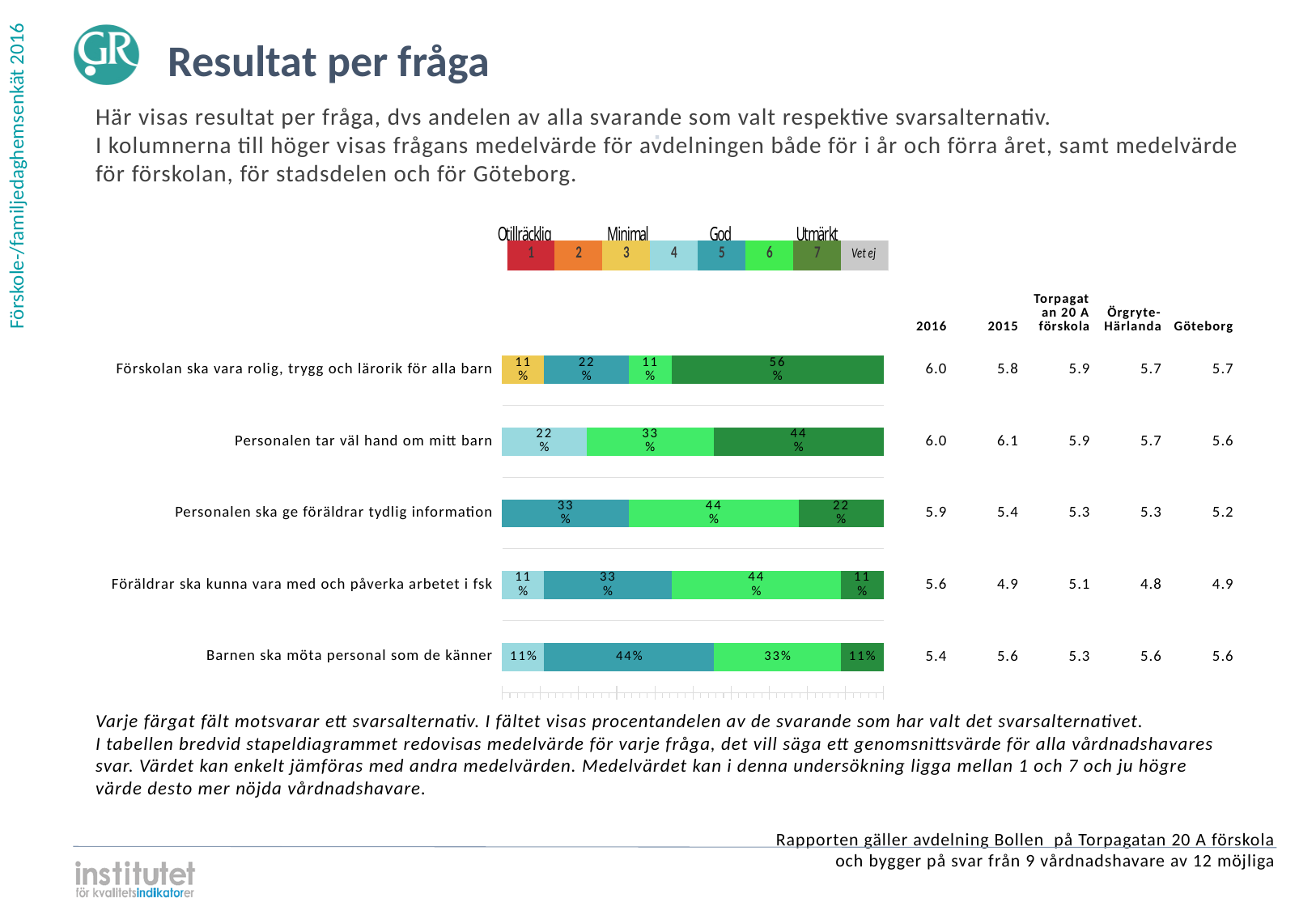
What percentage of respondents chose the teal (5) alternative for 'Barnen ska möta personal som de känner'? 44% What kind of chart is shown on the slide? Stacked bar chart What is the title of the slide containing the chart? Resultat per fråga What percentage of respondents chose the light green (6) alternative for 'Personalen ska ge föräldrar tydlig information'? 44% What percentage of respondents chose the dark green (7, Utmärkt) alternative for 'Förskolan ska vara rolig, trygg och lärorik för alla barn'? 56% How many answer alternatives does the colour legend above the chart list? 8 Which question has the largest single segment in its bar? Förskolan ska vara rolig, trygg och lärorik för alla barn How many questions (categories) are plotted in the bar chart? 5 What is the total of the segments in the bar for 'Personalen tar väl hand om mitt barn'? 99% What is the difference between the dark green (7) share for 'Personalen tar väl hand om mitt barn' and the dark green (7) share for 'Personalen ska ge föräldrar tydlig information'? 22% Which is larger: the light blue (4) share for 'Personalen tar väl hand om mitt barn' or the light blue (4) share for 'Föräldrar ska kunna vara med och påverka arbetet i fsk'? Personalen tar väl hand om mitt barn In the table next to the chart, what is the 2016 mean value for 'Föräldrar ska kunna vara med och påverka arbetet i fsk'? 5.6